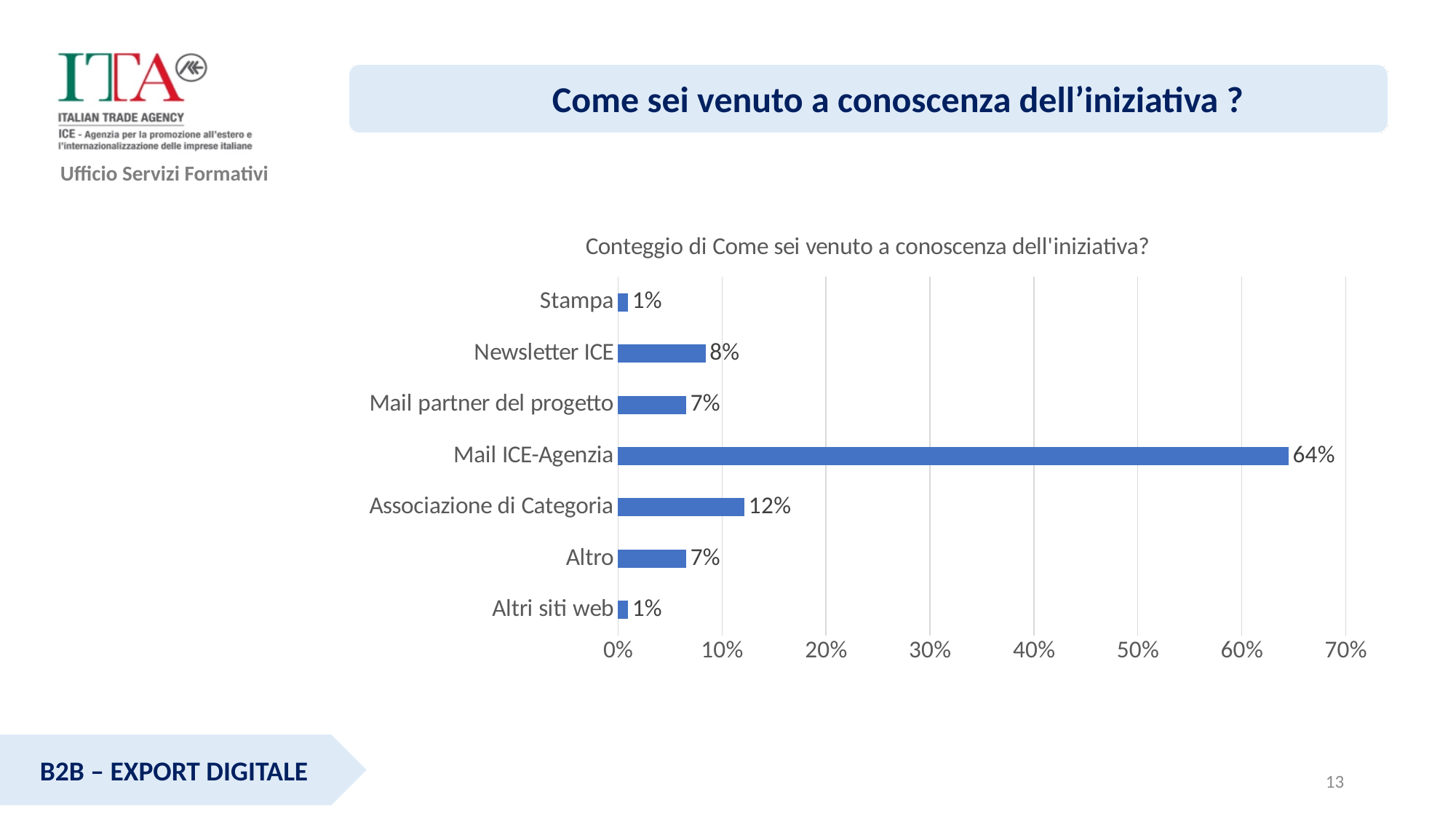
What is the title of the chart? Conteggio di Come sei venuto a conoscenza dell'iniziativa? What is the value for Mail partner del progetto? 7% What is the value for Associazione di Categoria? 12% What kind of chart is shown on the slide? bar chart Is the value for Mail ICE-Agenzia greater or less than 60%? greater What is the value for Mail ICE-Agenzia? 64% What is the difference between the values for Mail ICE-Agenzia and Associazione di Categoria? 52% Which is larger, the value for Newsletter ICE or the value for Altro? Newsletter ICE Which category has the highest value? Mail ICE-Agenzia How many categories are shown in the chart? 7 What is the highest value shown on the x axis? 70% What is the value for Newsletter ICE? 8%